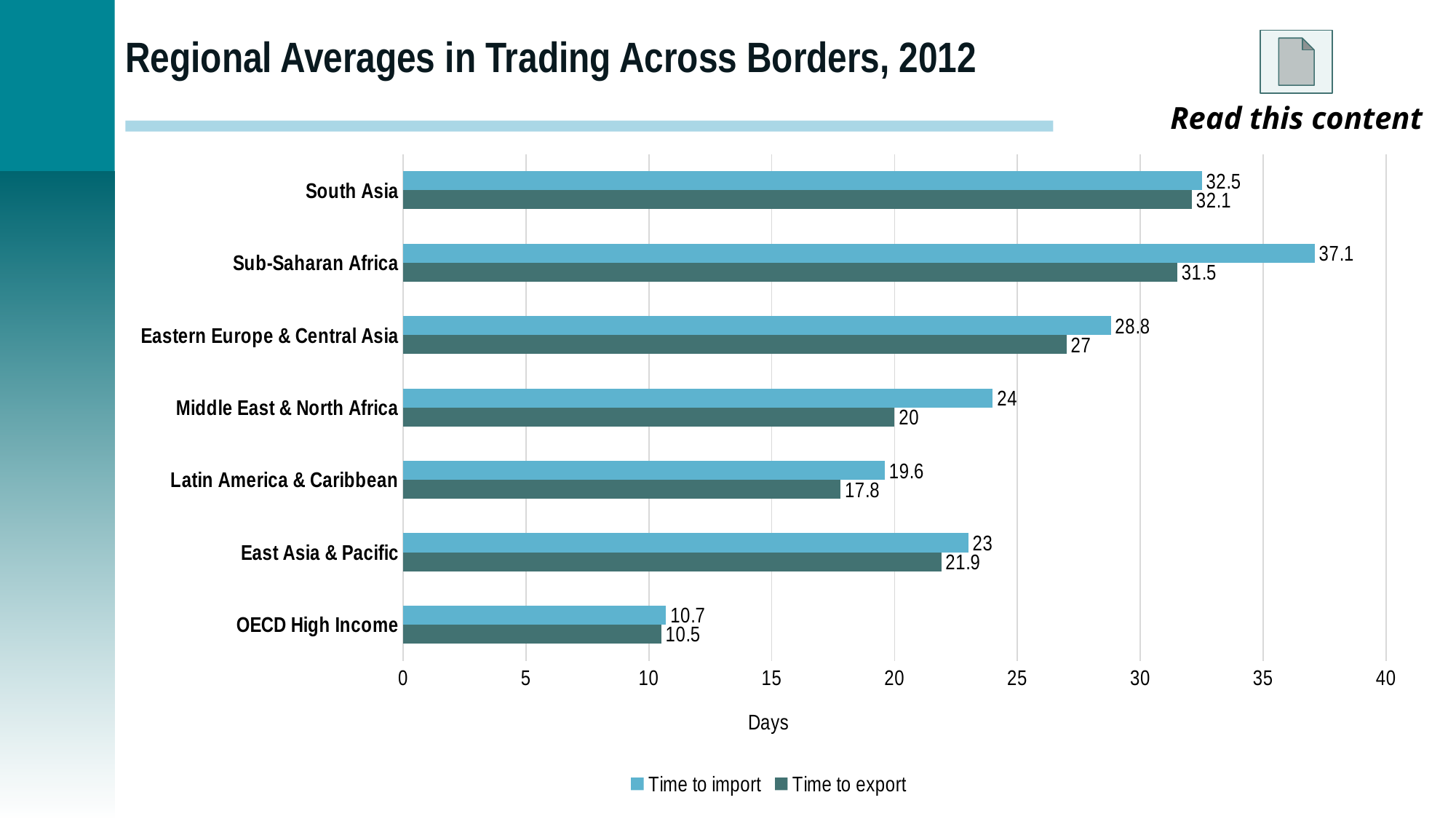
What is the difference between time to import and time to export for Sub-Saharan Africa? 5.6 Is the time to export for Eastern Europe & Central Asia greater or less than 25? greater What is the time to export for Latin America & Caribbean? 17.8 Which region has the lowest time to export? OECD High Income How many regions are shown in the chart? 7 Which region has the highest time to import? Sub-Saharan Africa What is the time to import for Sub-Saharan Africa? 37.1 What is the label of the horizontal axis? Days What kind of chart is shown on the slide? Bar chart Which is larger, the time to import for East Asia & Pacific or the time to import for Middle East & North Africa? Middle East & North Africa What is the time to export for Middle East & North Africa? 20 How many series does the legend list? 2